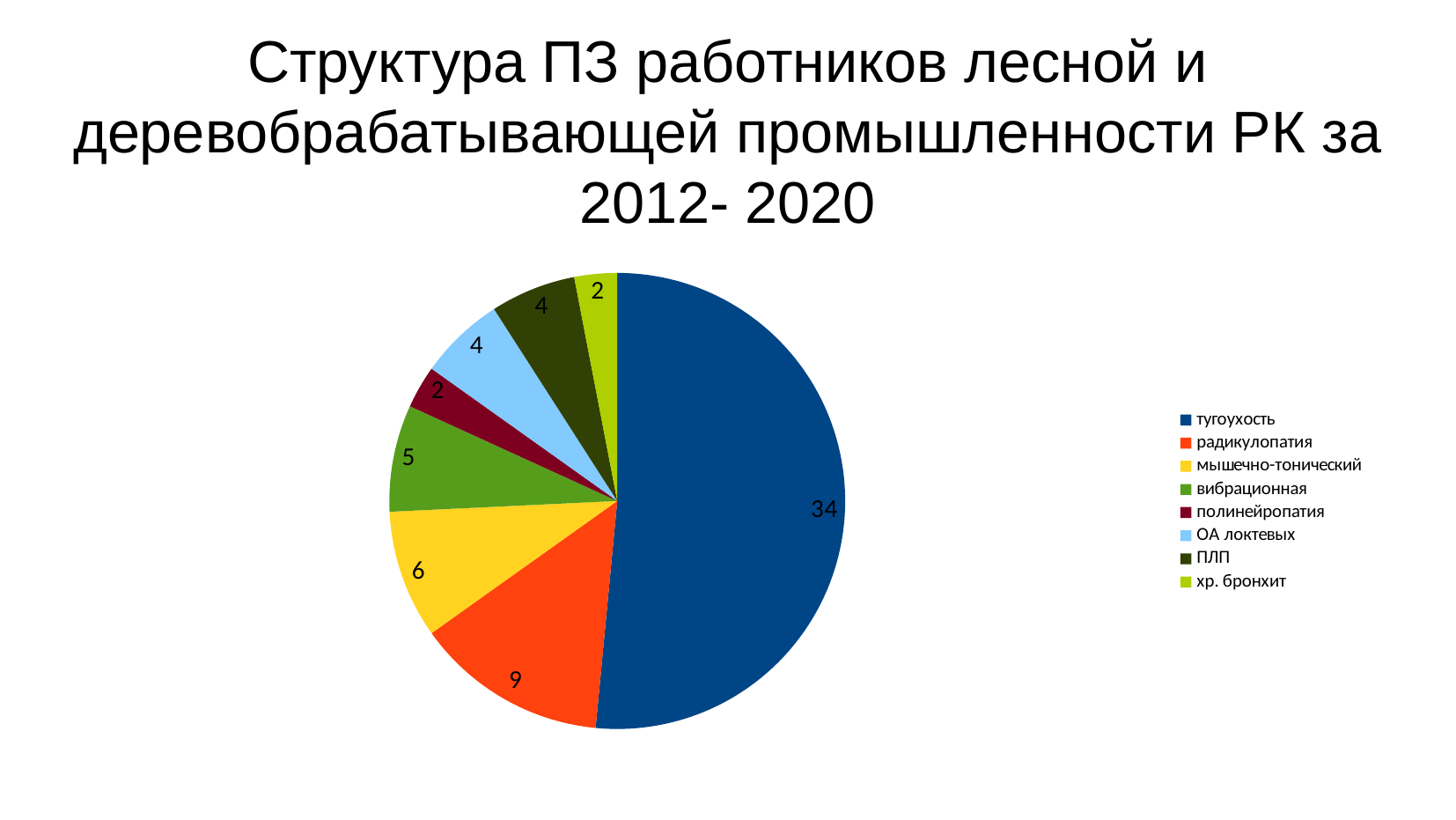
How many categories does the pie chart have? 8 Which category has the largest slice of the pie? тугоухость What is the value for ОА локтевых? 4 What kind of chart is shown on the slide? pie chart Does the тугоухость slice make up more than half of the pie? yes What is the value for радикулопатия? 9 What is the difference between the values for тугоухость and радикулопатия? 25 What colour is the slice for хр. бронхит? light green What is the value for вибрационная? 5 Which is larger, the value for радикулопатия or the value for мышечно-тонический? радикулопатия What is the total of all the slice values in the pie chart? 66 What is the value for тугоухость? 34